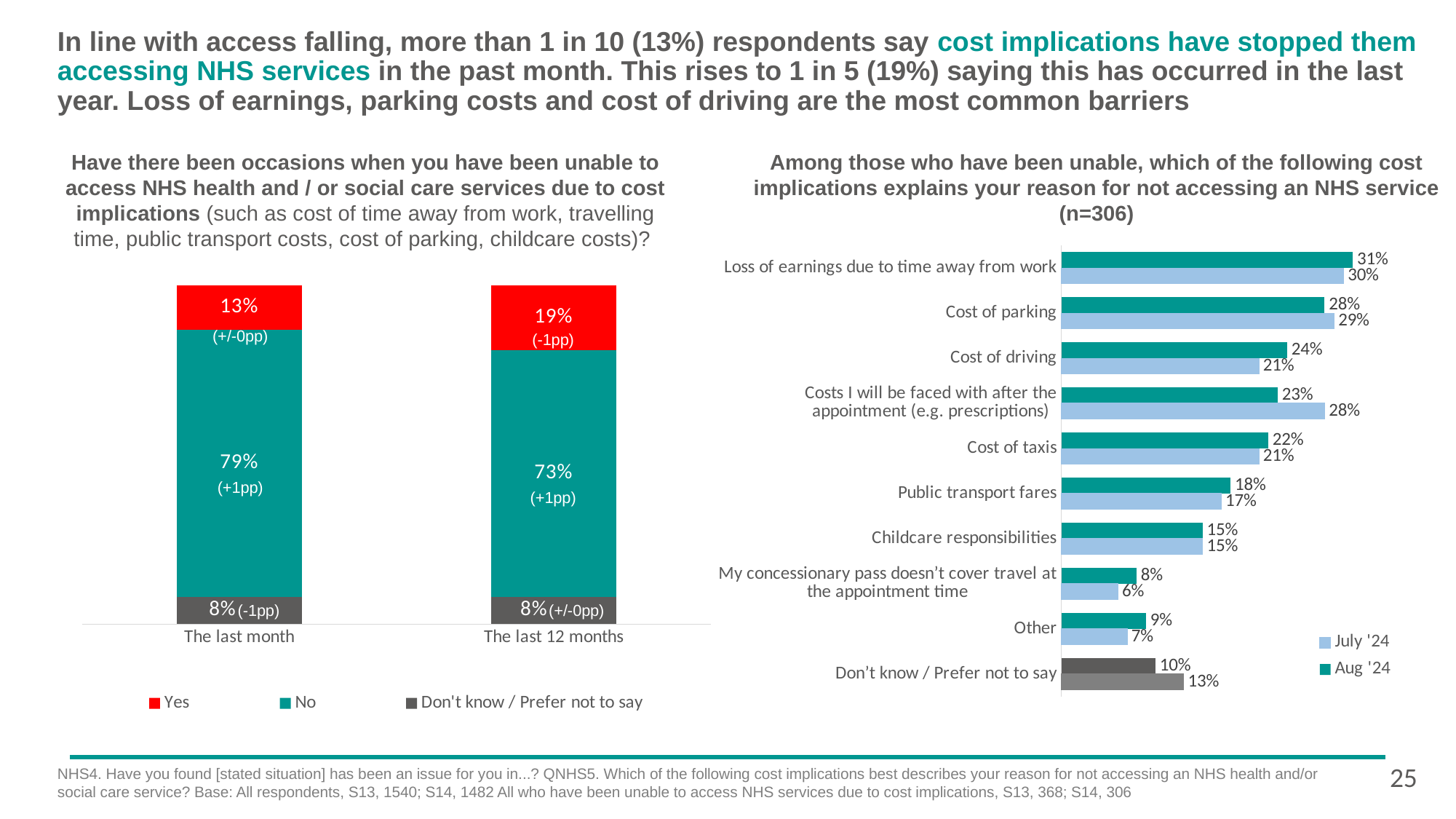
In the left chart, what percentage answered 'No' for the last 12 months? 73% In the right chart, which category has the lowest July '24 value? My concessionary pass doesn't cover travel at the appointment time In the right chart, which is larger for Cost of parking: the July '24 value or the Aug '24 value? July '24 What kind of chart is the right chart? Bar chart In the right chart, which category has the highest Aug '24 value? Loss of earnings due to time away from work In the left chart, what is the total of the stacked bar for the last month? 100% In the right chart, how many categories are shown? 10 In the right chart, what is the Aug '24 value for Cost of driving? 24% In the left chart, what is the difference between the 'Yes' values for the last 12 months and the last month? 6 percentage points In the right chart, what is the July '24 value for Costs I will be faced with after the appointment (e.g. prescriptions)? 28% In the left chart, how many series does the legend list? 3 In the left chart, what percentage answered 'Yes' for the last month? 13%